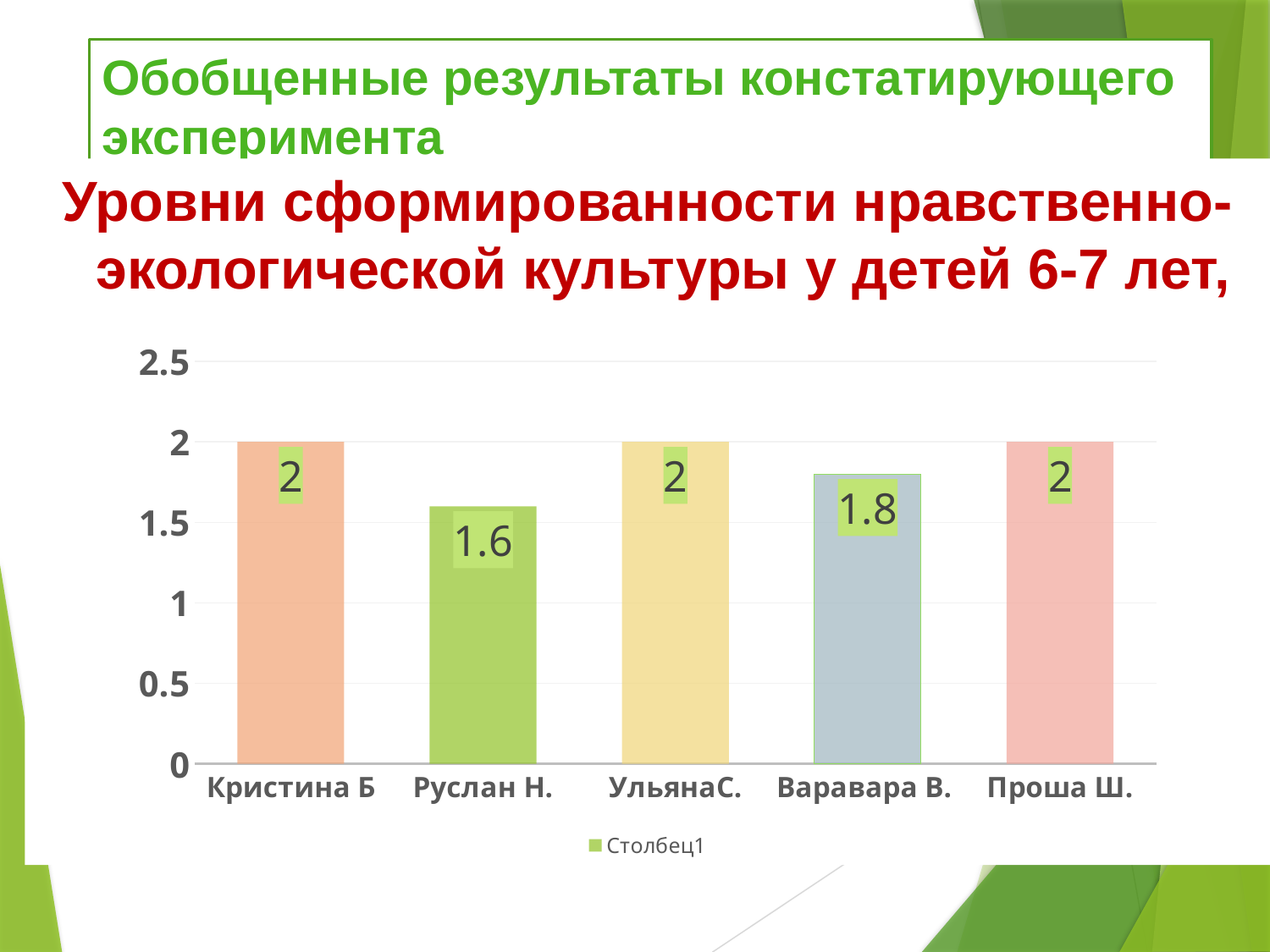
Which is larger, the value for УльянаС. or the value for Варавара В.? УльянаС. What is the value for Кристина Б? 2 How many series does the legend list? 1 What is the value for Руслан Н.? 1.6 What is the value for Варавара В.? 1.8 Which category has the lowest value? Руслан Н. How many categories are shown on the x axis? 5 What is the difference between the values for Варавара В. and Руслан Н.? 0.2 Is the value for Руслан Н. greater or less than 2? less What is the value for Проша Ш.? 2 What kind of chart is shown on the slide? bar chart What is the difference between the values for Кристина Б and Руслан Н.? 0.4